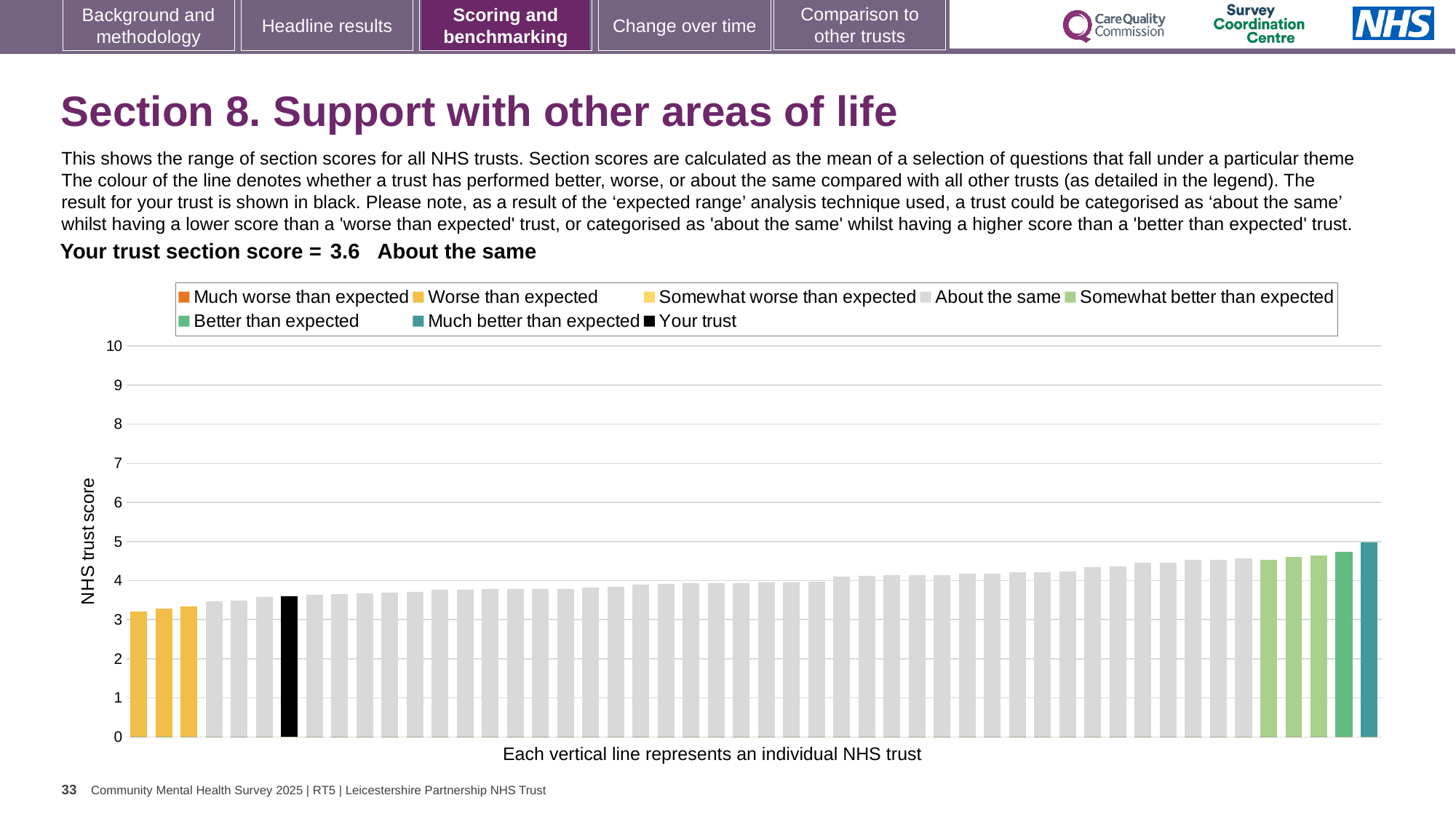
Is the value of the tallest bar greater or less than 4? greater Is the value of the tallest bar greater or less than 6? less What is the section score for your trust? 3.6 What kind of chart is shown on the slide? bar chart Which legend category does the tallest bar belong to? Much better than expected Do the bar values rise or fall from left to right along the x axis? rise Is the value for your trust's bar greater or less than 4? less Which category is your trust's section score placed in? About the same How many bars are coloured as 'Worse than expected'? 3 How many entries does the chart legend list? 8 What is the label on the y axis of the chart? NHS trust score